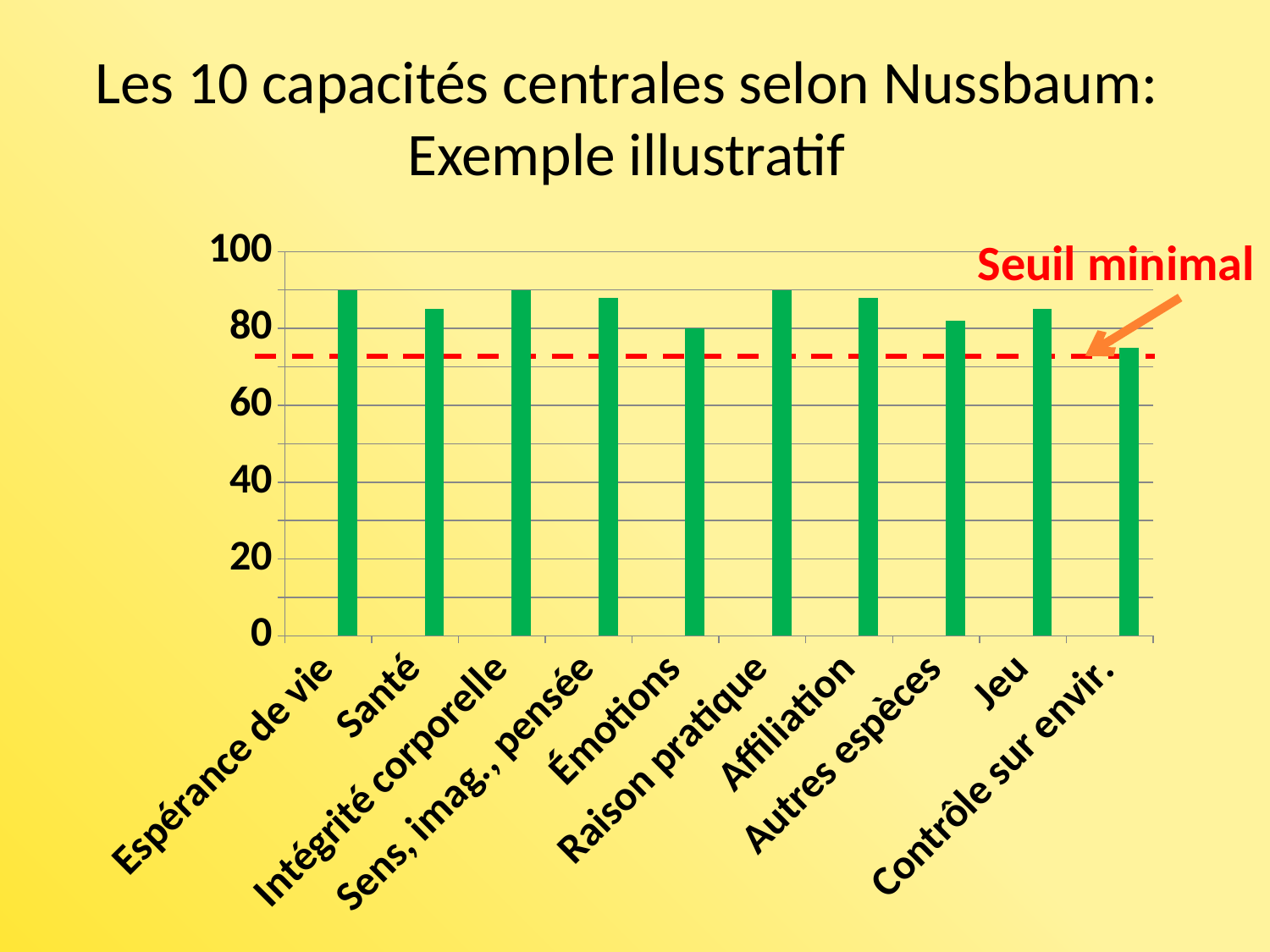
What is the highest value shown on the y axis? 100 What kind of chart is shown on the slide? bar chart Is the value for Santé greater or less than 60? greater Which category has the lowest bar? Contrôle sur envir. Is the value for Raison pratique greater or less than 80? greater What does the red dashed horizontal line represent, according to the label on the slide? Seuil minimal How many categories (capacities) are plotted on the x axis? 10 Is the value for Contrôle sur envir. greater or less than 80? less Which is larger, the value for Espérance de vie or the value for Contrôle sur envir.? Espérance de vie What colour are the bars in the chart? green Which is larger, the value for Intégrité corporelle or the value for Émotions? Intégrité corporelle